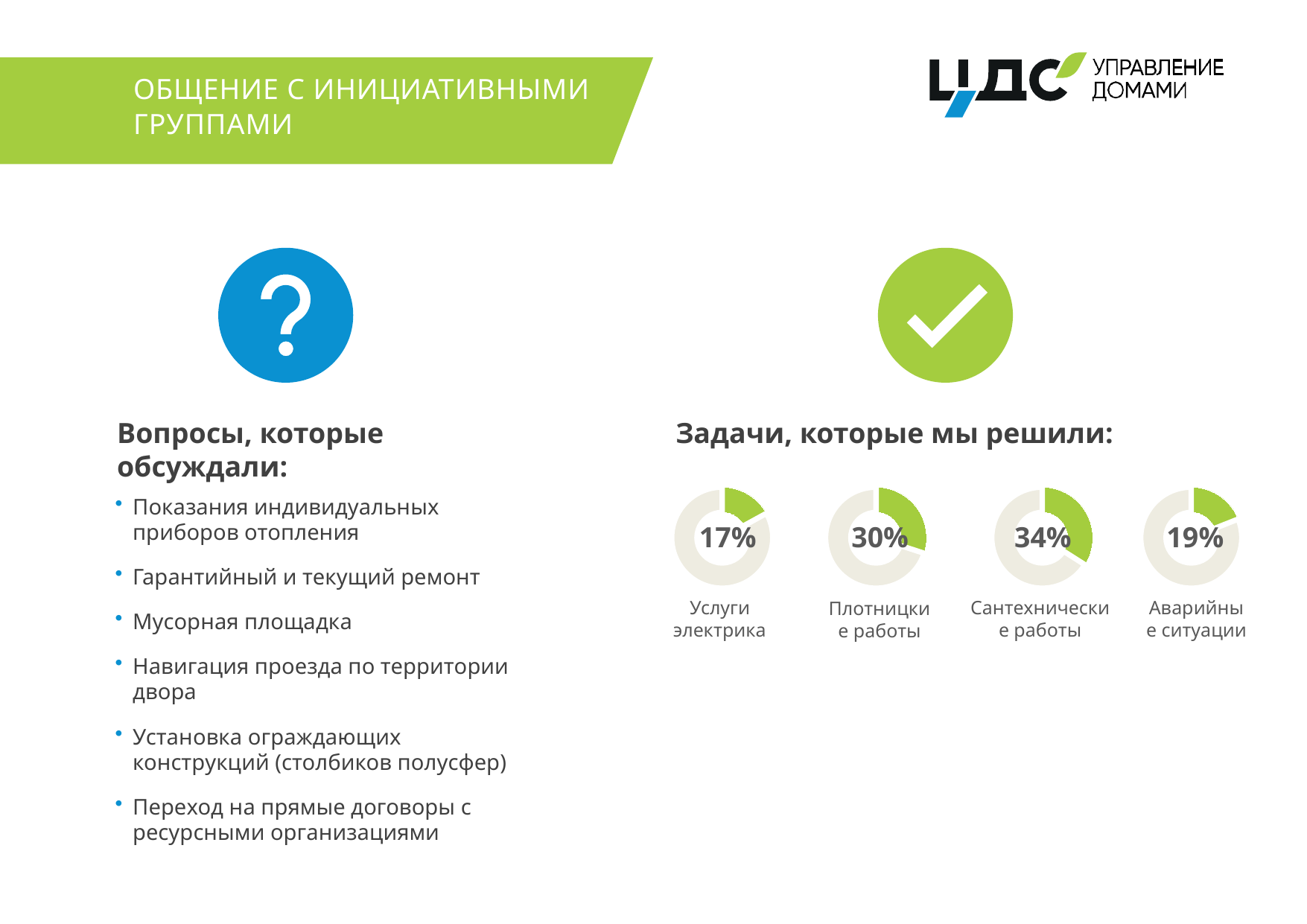
What percentage is shown in the donut chart labelled "Сантехнические работы"? 34% What type of chart is used to display the percentages under "Задачи, которые мы решили"? Donut chart What is the difference between the percentages shown for "Сантехнические работы" and "Услуги электрика"? 17% What is the difference between the percentages shown for "Плотницкие работы" and "Аварийные ситуации"? 11% Among the four donut charts under "Задачи, которые мы решили", which category has the highest percentage? Сантехнические работы What percentage is shown in the donut chart labelled "Услуги электрика"? 17% What percentage is shown in the donut chart labelled "Плотницкие работы"? 30% What colour is the filled segment in each of the four donut charts? Green How many donut charts are shown under the heading "Задачи, которые мы решили"? 4 What percentage is shown in the donut chart labelled "Аварийные ситуации"? 19% Among the four donut charts under "Задачи, которые мы решили", which category has the lowest percentage? Услуги электрика Which has a larger percentage: "Плотницкие работы" or "Аварийные ситуации"? Плотницкие работы